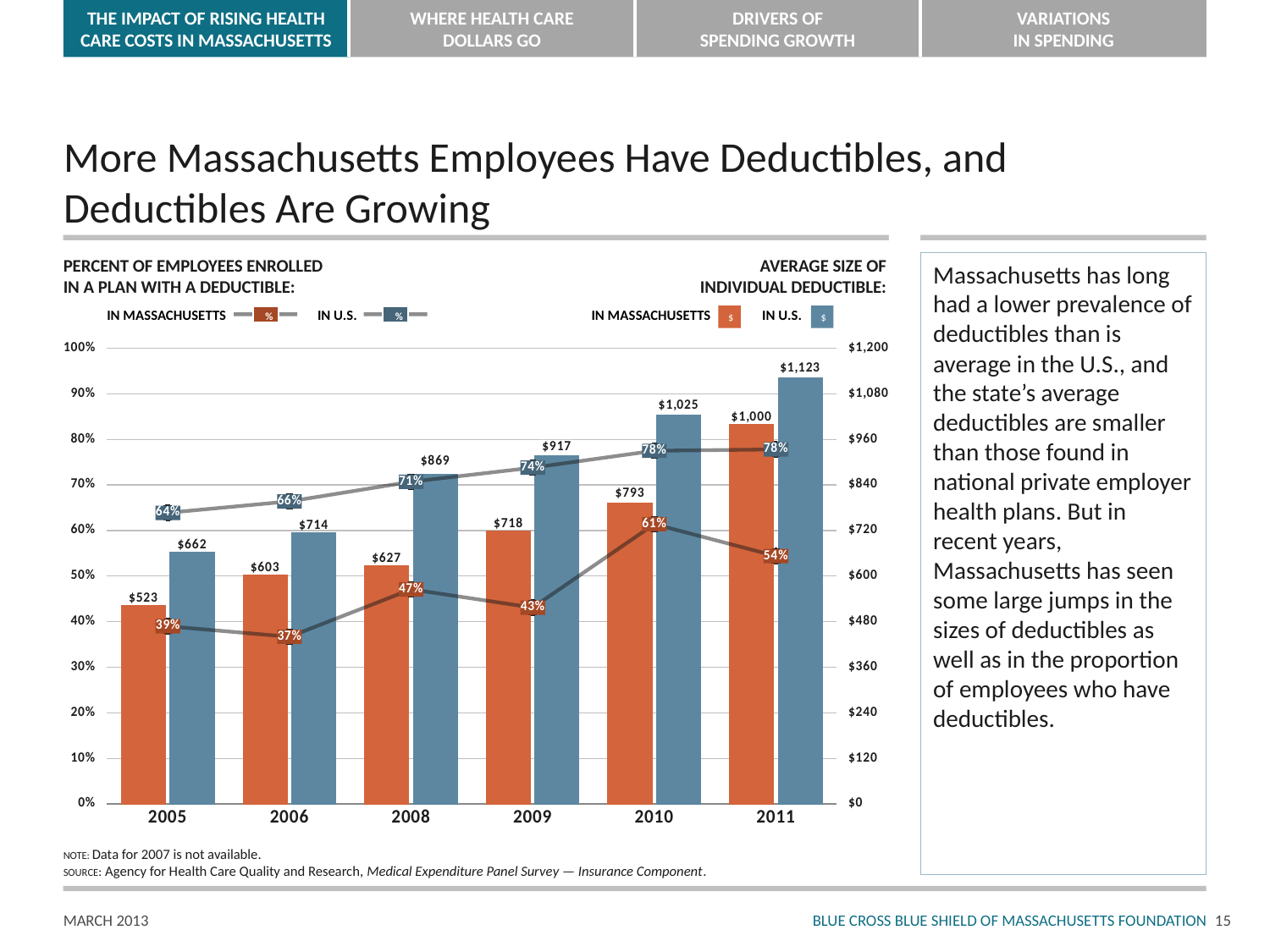
Did the average size of the individual deductible in the U.S. rise or fall from 2005 to 2011? Rise How many years are shown on the x axis of the chart? 6 Which was larger in 2011: the average individual deductible in Massachusetts or in the U.S.? In U.S. How many series does the chart's legend list in total? 4 In which year was the percent of Massachusetts employees enrolled in a plan with a deductible lowest? 2006 Which year's data is noted as not available on the slide? 2007 What percent of U.S. employees were enrolled in a plan with a deductible in 2005? 64% What is the difference between the average U.S. and Massachusetts individual deductible in 2009? $199 What was the average size of an individual deductible in Massachusetts in 2011? $1,000 What was the average size of an individual deductible in the U.S. in 2008? $869 In which year was the average U.S. individual deductible highest? 2011 What percent of Massachusetts employees were enrolled in a plan with a deductible in 2010? 61%